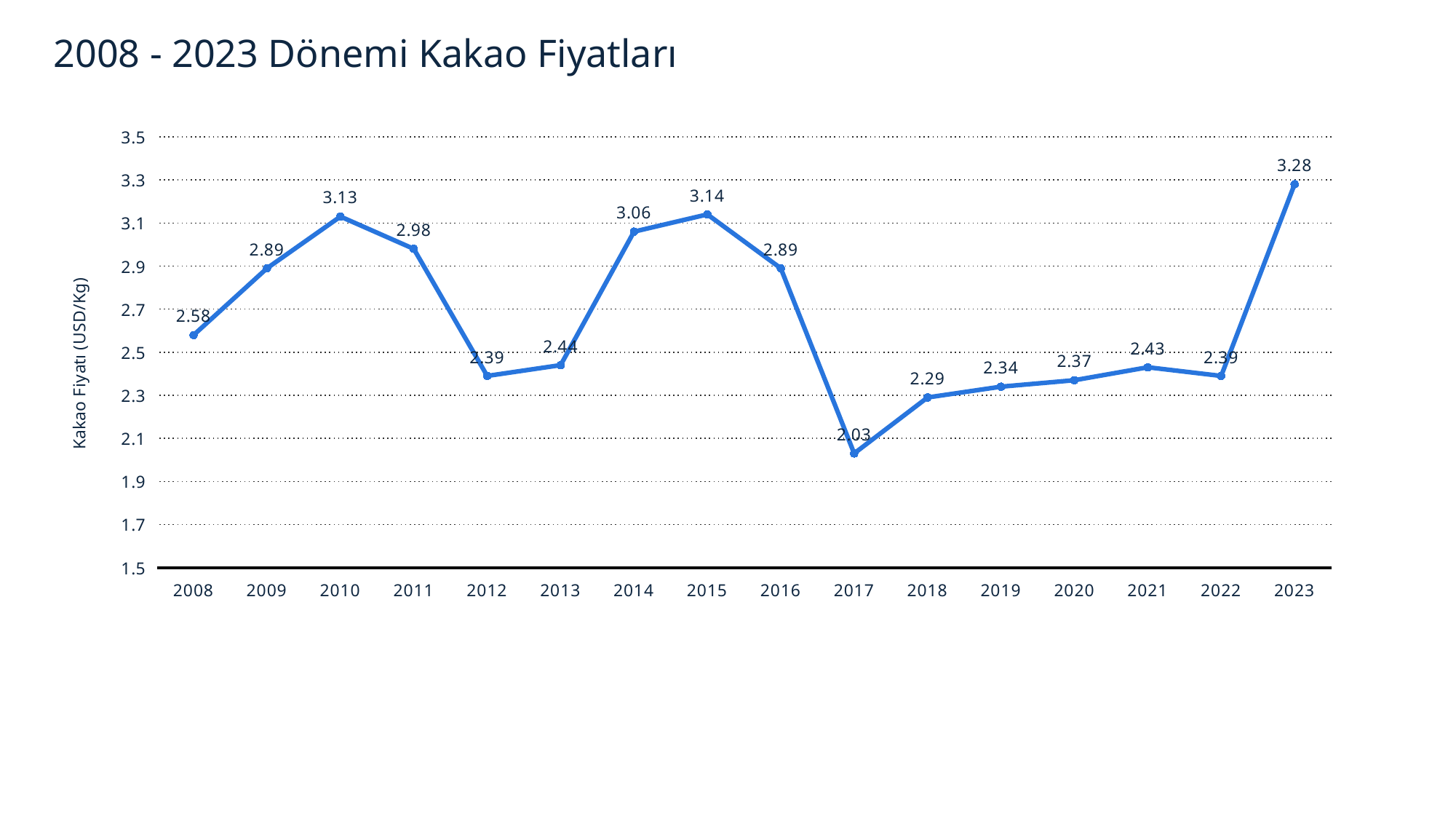
Which year has a higher cocoa price, 2015 or 2016? 2015 What is the title of the chart? 2008 - 2023 Dönemi Kakao Fiyatları How many years are plotted on the chart? 16 Is the cocoa price for 2014 greater or less than 2.9? greater What is the cocoa price for 2017? 2.03 Which year has the highest cocoa price? 2023 What is the cocoa price for 2023? 3.28 What kind of chart is shown on the slide? line chart Do cocoa prices rise or fall from 2017 to 2021? rise What is the difference between the cocoa price in 2023 and in 2017? 1.25 What is the cocoa price for 2010? 3.13 Which year has the lowest cocoa price? 2017